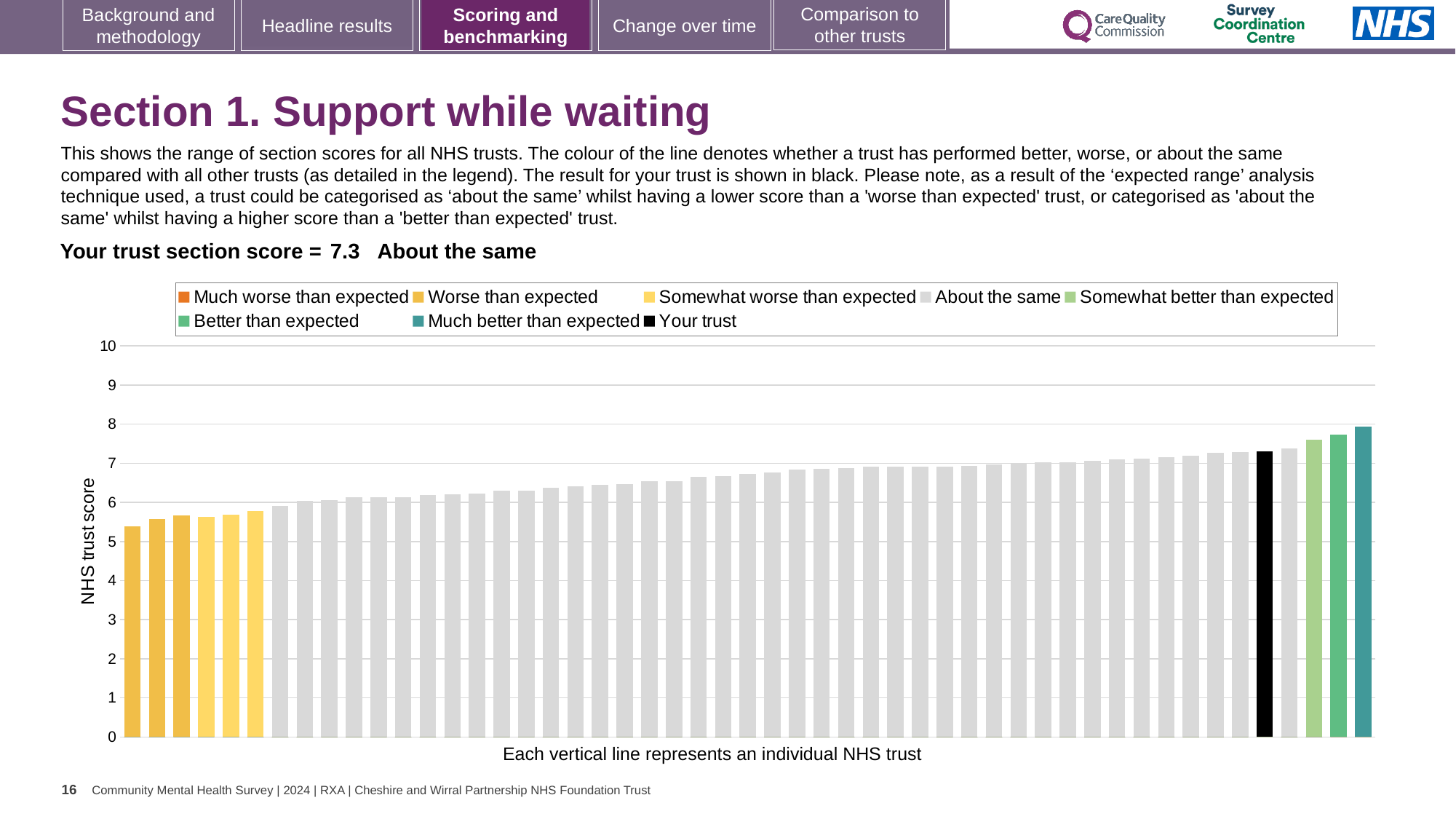
Is the value of the leftmost (lowest) bar greater or less than 6? less Do the bar values rise or fall from left to right across the chart? Rise What kind of chart is shown on the slide? Bar chart Is the value of the black bar (your trust) greater or less than 8? less Is the value of the black bar (your trust) greater or less than 7? greater What is the label on the vertical axis of the chart? NHS trust score How many entries does the chart legend list? 8 What is the section score for your trust shown on the slide? 7.3 Which performance category is your trust's section score placed in? About the same What colour is the bar representing your trust? Black How many bars are coloured as 'Worse than expected' (yellow) at the left of the chart? 3